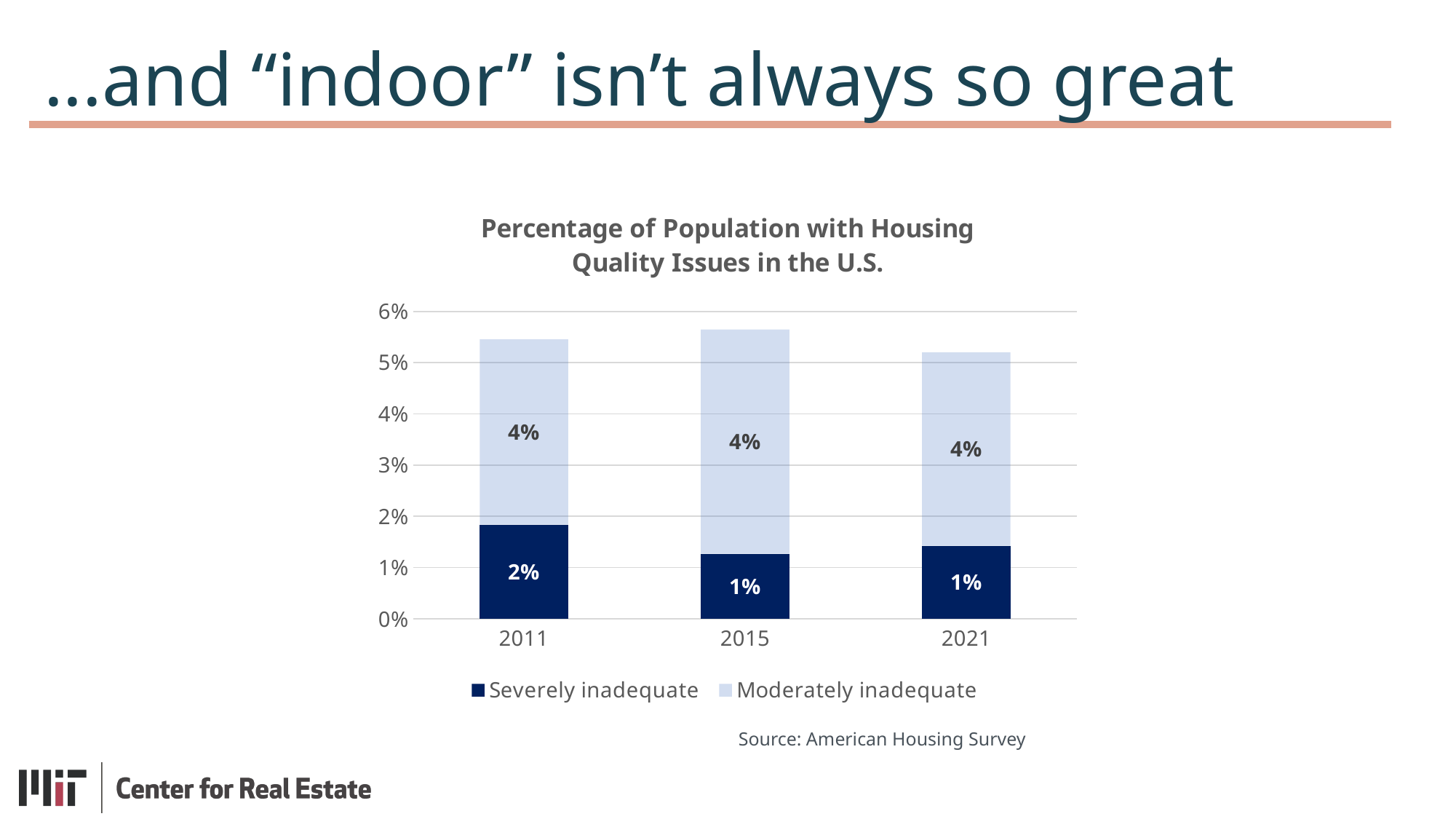
What kind of chart is shown on the slide? Stacked bar chart Which is larger, the Severely inadequate value in 2011 or in 2015? 2011 What is the difference between the Severely inadequate value in 2011 and in 2021? 1% Is the total height of the 2011 stacked bar greater or less than 5%? greater What is the value for Moderately inadequate in 2015? 4% What is the value for Severely inadequate in 2021? 1% What is the title of the chart? Percentage of Population with Housing Quality Issues in the U.S. How many series does the legend list? 2 In which year is the Severely inadequate value highest? 2011 What is the value for Severely inadequate in 2011? 2% Is the total height of the 2021 stacked bar greater or less than 6%? less How many years are shown on the x axis? 3